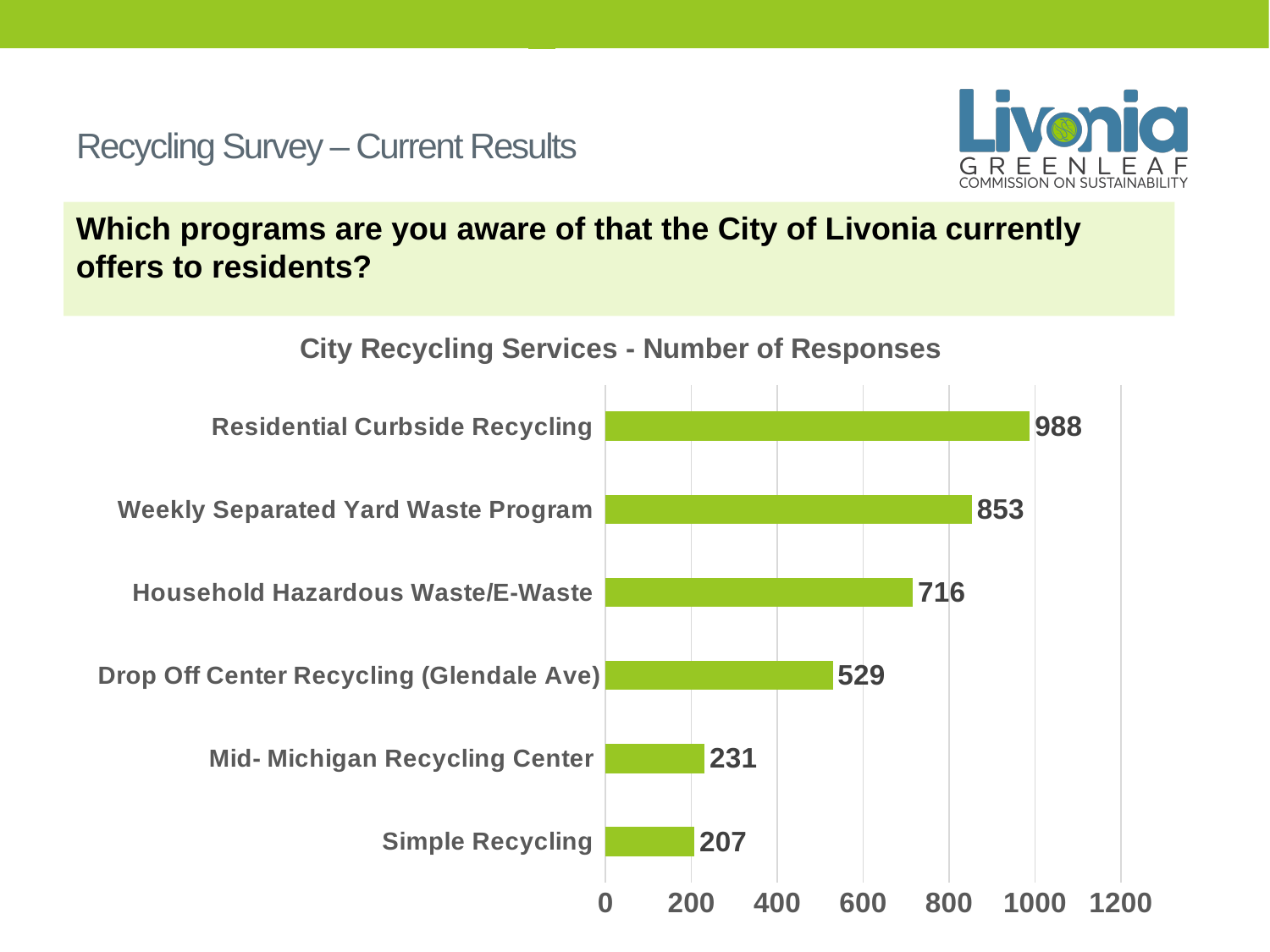
How many responses did Residential Curbside Recycling receive? 988 Is the value for Weekly Separated Yard Waste Program greater or less than 800? greater How many programs are shown in the chart? 6 Which program has the lowest number of responses? Simple Recycling How many responses are shown for Drop Off Center Recycling (Glendale Ave)? 529 What is the number of responses for Household Hazardous Waste/E-Waste? 716 What is the difference in responses between Mid- Michigan Recycling Center and Simple Recycling? 24 What is the title of the chart? City Recycling Services - Number of Responses What is the difference in responses between Residential Curbside Recycling and Weekly Separated Yard Waste Program? 135 What kind of chart is shown on the slide? Bar chart Which received more responses, Household Hazardous Waste/E-Waste or Drop Off Center Recycling (Glendale Ave)? Household Hazardous Waste/E-Waste Which program has the highest number of responses? Residential Curbside Recycling